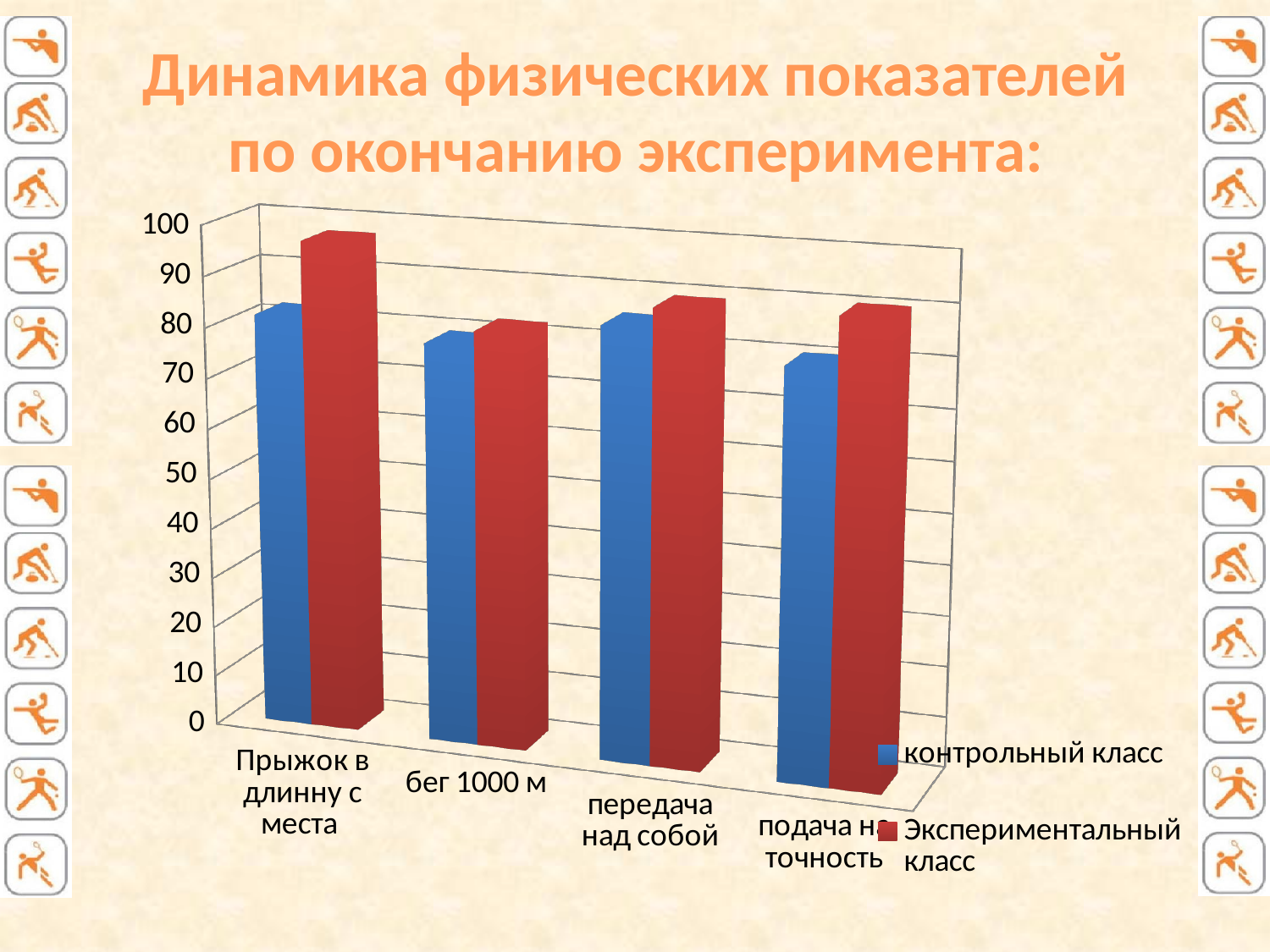
For подача на точность, which series has the larger value? Экспериментальный класс What is the title of the slide? Динамика физических показателей по окончанию эксперимента: Is the value for Экспериментальный класс in Прыжок в длинну с места greater or less than 90? greater What kind of chart is shown on the slide? bar chart Is the value for контрольный класс in бег 1000 м greater or less than 60? greater How many categories are shown on the x axis of the chart? 4 For Прыжок в длинну с места, which series has the larger value? Экспериментальный класс Which series are listed in the legend? контрольный класс, Экспериментальный класс How many series does the legend list? 2 Which category has the highest value for Экспериментальный класс? Прыжок в длинну с места